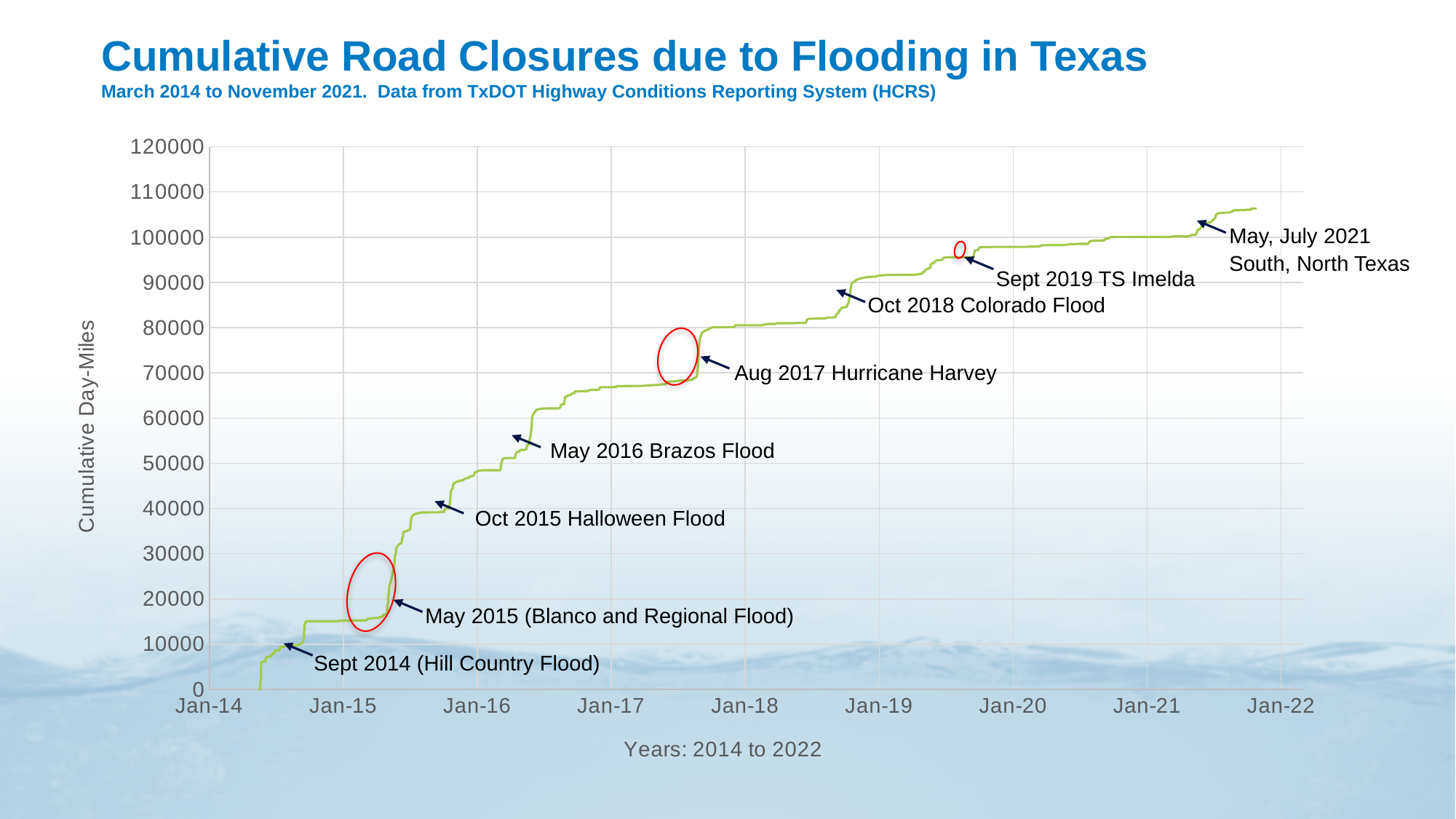
Is the final value of the line, near the end of 2021, greater or less than 110000? less What is the title of the chart? Cumulative Road Closures due to Flooding in Texas Do the plotted values rise or fall from Jan-14 to Jan-22? rise Is the value at Jan-19 greater or less than 80000? greater Which annotated event is associated with the jump in the line in August 2017? Hurricane Harvey Is the value at Jan-15 greater or less than 20000? less What kind of chart is shown on the slide? line chart How many lines (series) are plotted on the chart? 1 What is the label of the vertical axis? Cumulative Day-Miles